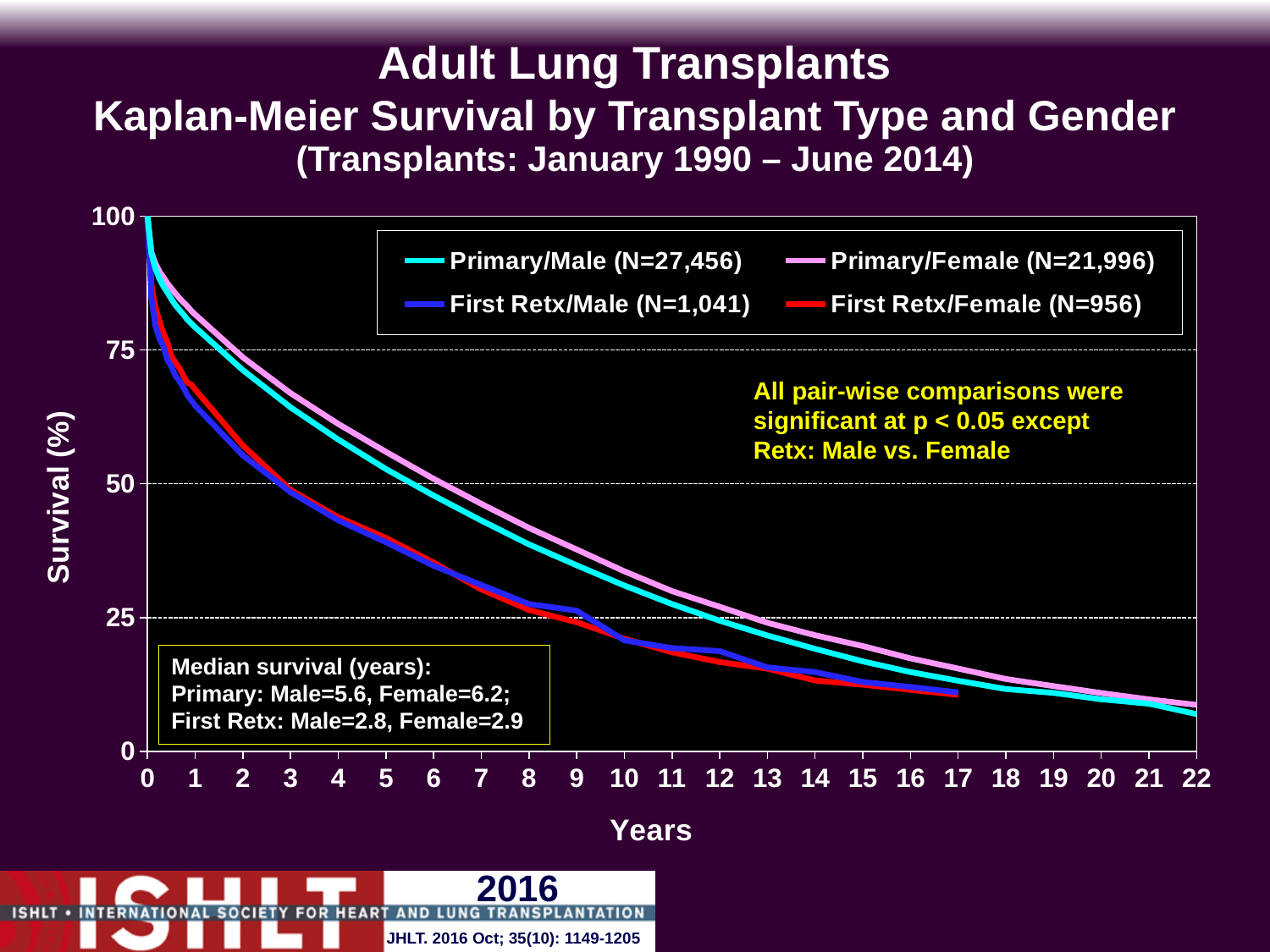
What is the median survival in years for First Retx/Male transplants? 2.8 Is the survival value for Primary/Male at year 10 greater or less than 25? greater Is the survival value for First Retx/Male at year 5 greater or less than 50? less At year 5, which series has higher survival: Primary/Female or First Retx/Female? Primary/Female What is the N for the Primary/Male series in the legend? 27,456 What is the median survival in years for Primary/Female transplants? 6.2 How many series does the legend list? 4 Which series has the highest survival at year 10? Primary/Female What kind of chart is shown on the slide? line chart What is the difference in median survival (years) between Primary Female and Primary Male? 0.6 Do the survival curves rise or fall as years increase? fall Which series has the smallest N in the legend? First Retx/Female (N=956)